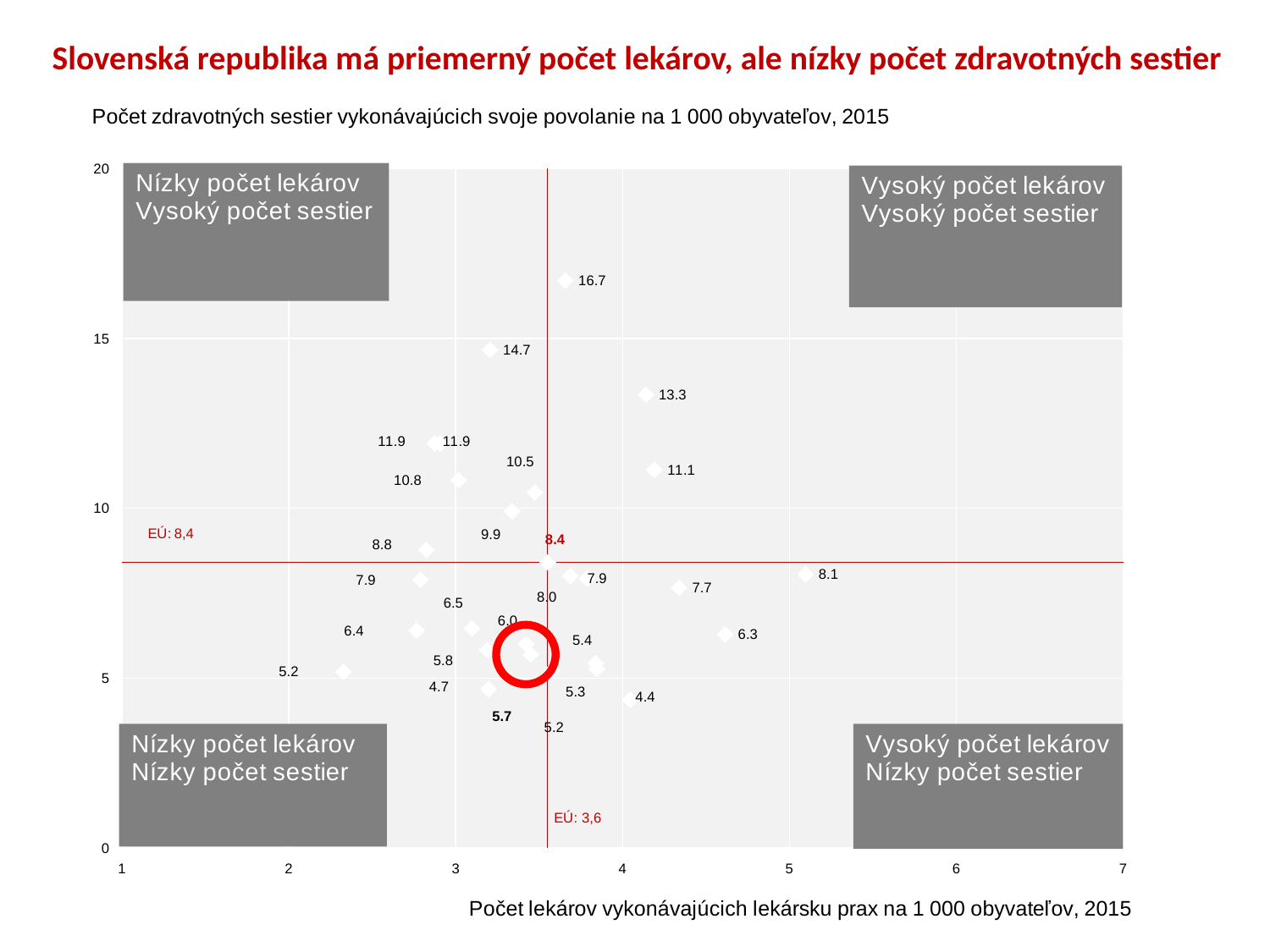
Which is larger, the point labeled 13.3 or the point labeled 11.1? 13.3 What is the lowest labeled value for nurses per 1 000 inhabitants on the chart? 4.4 Is the number of doctors per 1 000 inhabitants for the point labeled 16.7 greater or less than 3? greater What is the highest labeled value for nurses per 1 000 inhabitants on the chart? 16.7 What is the EU average number of nurses per 1 000 inhabitants marked by the horizontal line? 8,4 What is the difference between the two highest labeled points, 16.7 and 14.7? 2.0 What is the difference between the highest labeled value (16.7) and the lowest labeled value (4.4)? 12.3 Is the number of doctors per 1 000 inhabitants for the point labeled 6.3 greater or less than 4? greater What is the EU average number of doctors per 1 000 inhabitants marked by the vertical line? 3,6 What is the title of the x axis? Počet lekárov vykonávajúcich lekársku prax na 1 000 obyvateľov, 2015 What kind of chart is shown on the slide? scatter chart What does the label in the top-left quadrant of the chart say? Nízky počet lekárov, Vysoký počet sestier